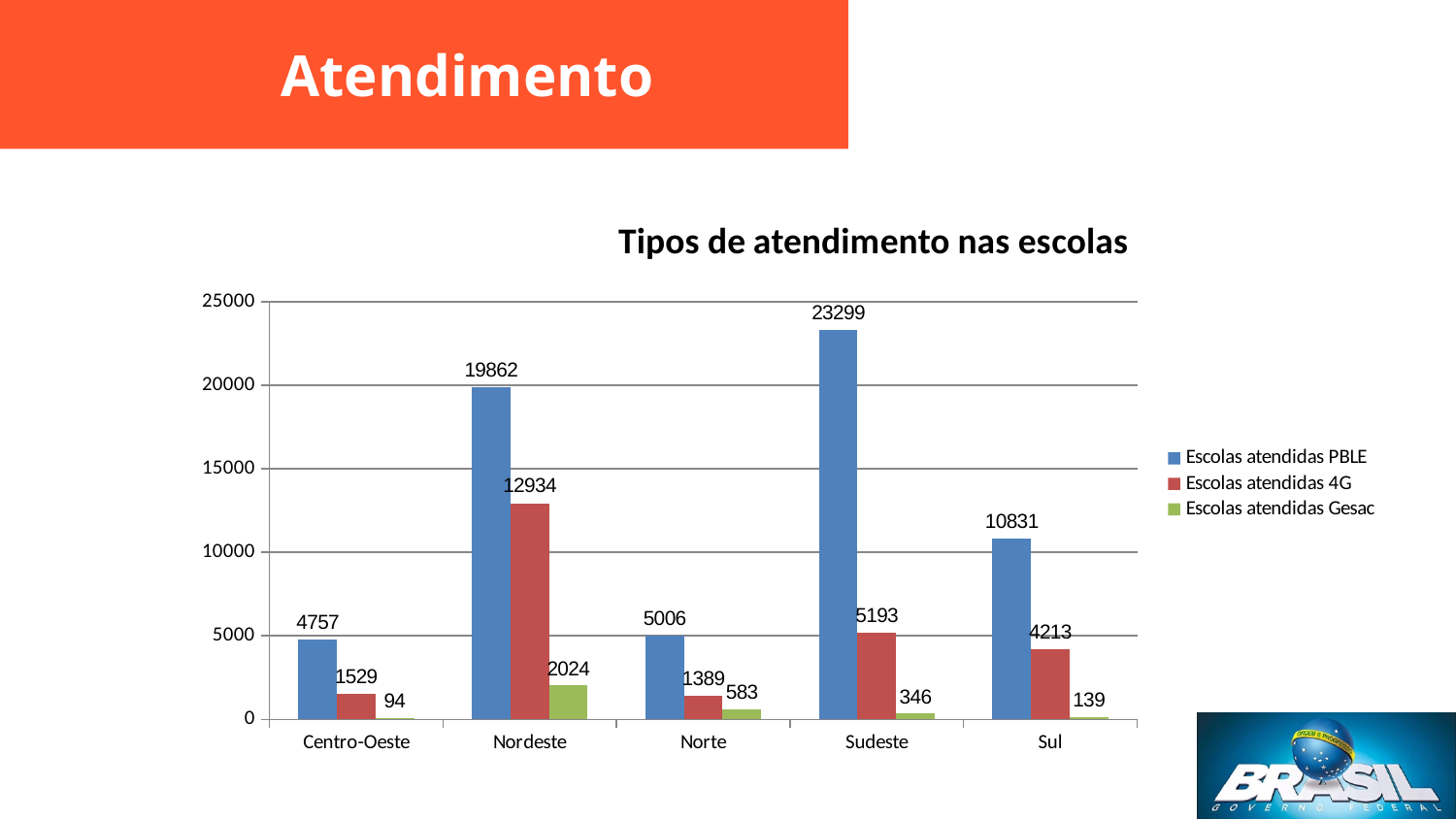
Which region has the lowest value for Escolas atendidas Gesac? Centro-Oeste What is the value for Escolas atendidas Gesac in Centro-Oeste? 94 How many series does the legend list? 3 What is the value for Escolas atendidas 4G in Nordeste? 12934 What is the title of the chart? Tipos de atendimento nas escolas What is the value for Escolas atendidas PBLE in Sudeste? 23299 Which region has the highest value for Escolas atendidas PBLE? Sudeste How many regions are shown on the x axis? 5 What kind of chart is shown? bar chart What is the value for Escolas atendidas Gesac in Norte? 583 What is the difference between Escolas atendidas PBLE and Escolas atendidas 4G in Sul? 6618 Which is larger: Escolas atendidas 4G in Sudeste or Escolas atendidas 4G in Sul? Escolas atendidas 4G in Sudeste